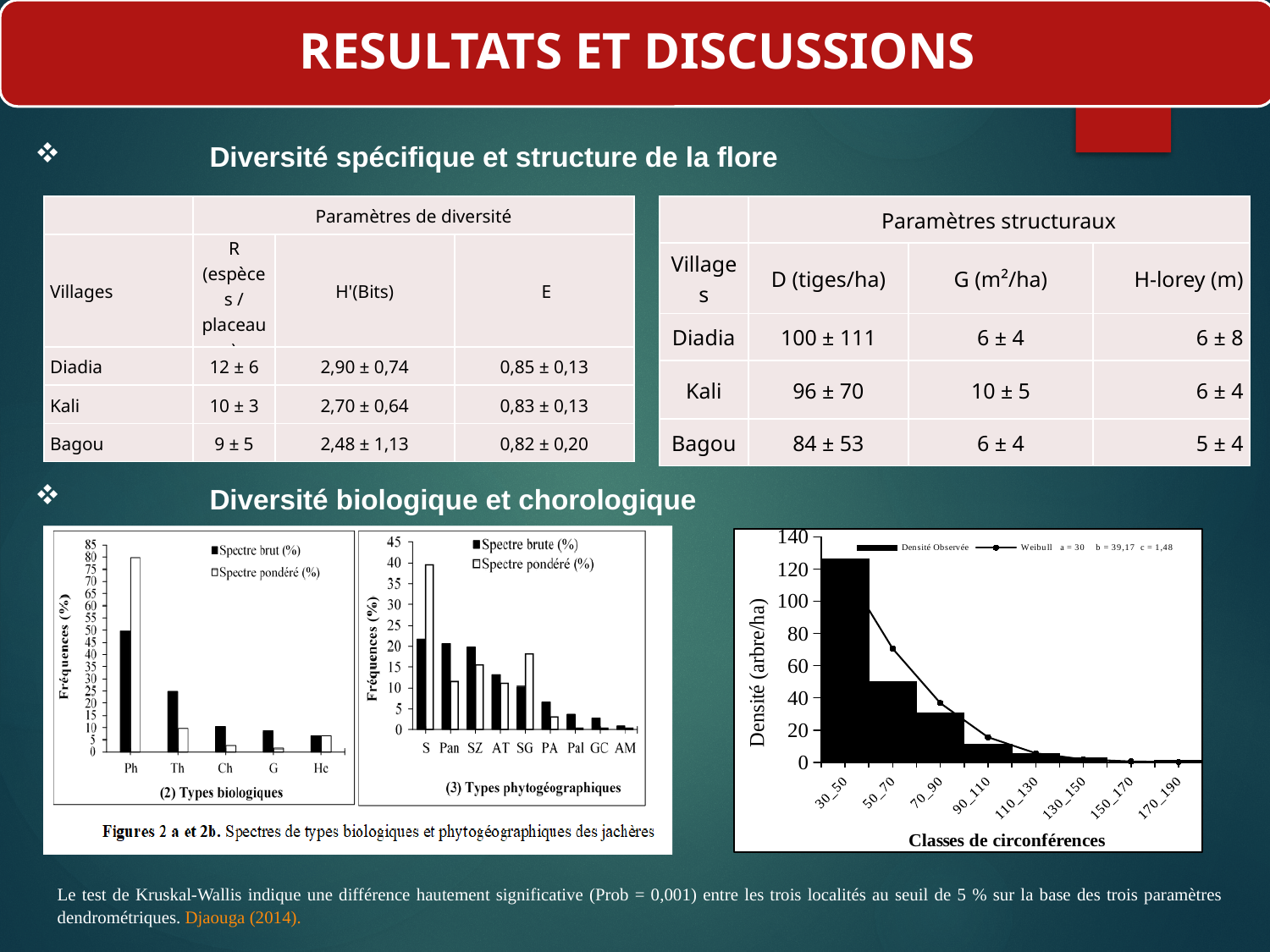
In the chart titled '(3) Types phytogéographiques', which category has the highest Spectre pondéré (%) value? S In the chart titled '(2) Types biologiques', which category has the highest Spectre brut (%) value? Ph In the chart titled '(2) Types biologiques', is the Spectre pondéré (%) value for Ph greater or less than 75? greater In the chart titled '(3) Types phytogéographiques', is the Spectre pondéré (%) value for S greater or less than 35? greater In the chart titled '(2) Types biologiques', which is larger for Th: Spectre brut (%) or Spectre pondéré (%)? Spectre brut (%) In the chart titled '(2) Types biologiques', is the Spectre brut (%) value for Th greater or less than 20? greater In the 'Classes de circonférences' chart on the right, do the Densité Observée values rise or fall as the circumference class increases? fall In the chart titled '(3) Types phytogéographiques', how many categories are shown on the x axis? 9 In the chart titled '(3) Types phytogéographiques', how many series does the legend list? 2 In the chart titled '(2) Types biologiques', how many categories are shown on the x axis? 5 In the 'Classes de circonférences' chart on the right, how many circumference classes are shown on the x axis? 8